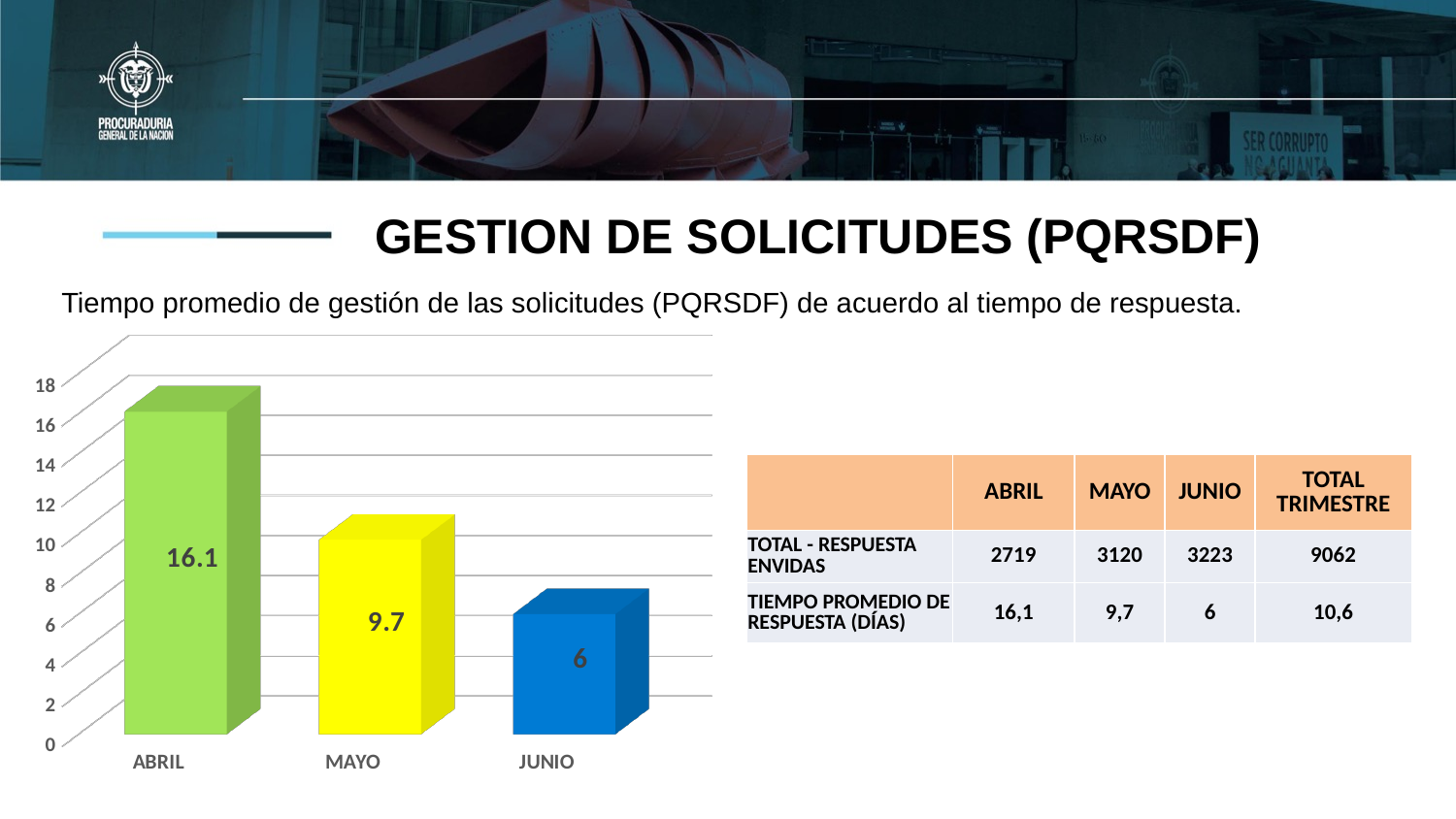
Which is larger in the bar chart, the value for MAYO or the value for JUNIO? MAYO Which month has the lowest value in the bar chart? JUNIO What is the difference between the values for MAYO and JUNIO in the bar chart? 3.7 What is the difference between the values for ABRIL and MAYO in the bar chart? 6.4 What is the value for MAYO in the bar chart? 9.7 Which month has the highest value in the bar chart? ABRIL What kind of chart is shown on the slide? bar chart Is the value for ABRIL in the bar chart greater or less than 14? greater What is the value for JUNIO in the bar chart? 6 How many months are shown in the bar chart? 3 Do the values in the bar chart rise or fall from ABRIL to JUNIO? fall What is the value for ABRIL in the bar chart? 16.1